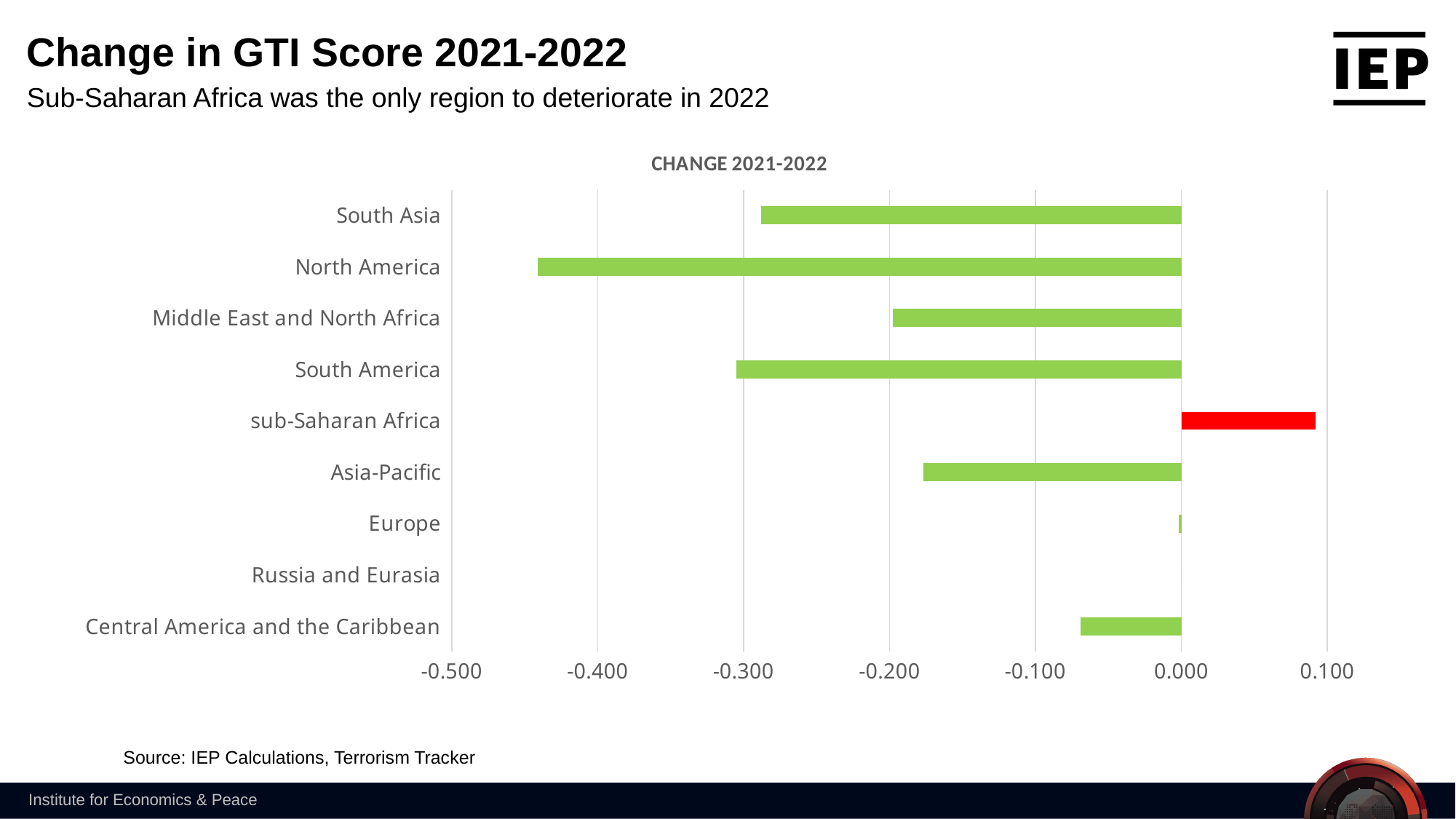
Is the value for sub-Saharan Africa greater or less than 0.000? greater Is the value for Asia-Pacific greater or less than -0.200? greater Which region has the lowest change in GTI score (largest decrease)? North America What is the title printed above the chart? CHANGE 2021-2022 Which region's bar is coloured red? sub-Saharan Africa Is the value for Central America and the Caribbean greater or less than -0.100? greater What kind of chart is shown on the slide? bar chart Which region shows a larger decrease in GTI score, North America or South Asia? North America How many regions are listed on the chart? 9 Which region has the highest (only positive) change in GTI score? sub-Saharan Africa Which region has the larger value, Asia-Pacific or Middle East and North Africa? Asia-Pacific